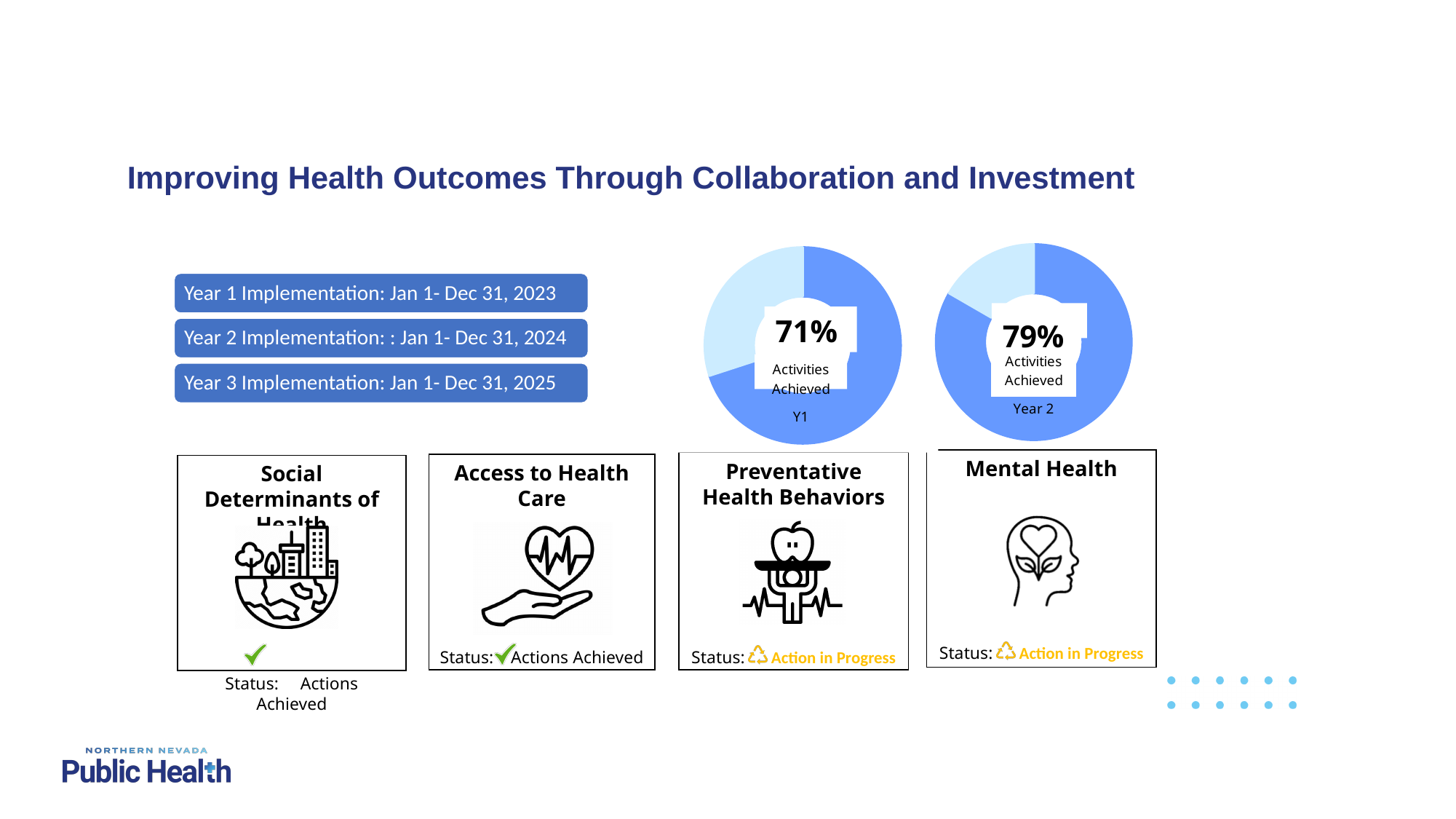
How many slices does the Y1 pie chart have? 2 In the left pie chart (Y1), what percentage of activities were achieved? 71% By how many percentage points did the activities achieved increase from Y1 to Year 2? 8 What kind of chart is used to show the activities achieved for Y1 and Year 2? pie chart Which year shows the lower percentage of activities achieved, Y1 or Year 2? Y1 Does the percentage of activities achieved rise or fall from Y1 to Year 2? rise How many pie charts are shown on the slide? 2 In the right pie chart (Year 2), what percentage of activities were achieved? 79% What label appears below the percentage in the right pie chart? Activities Achieved Year 2 Which year shows the higher percentage of activities achieved, Y1 or Year 2? Year 2